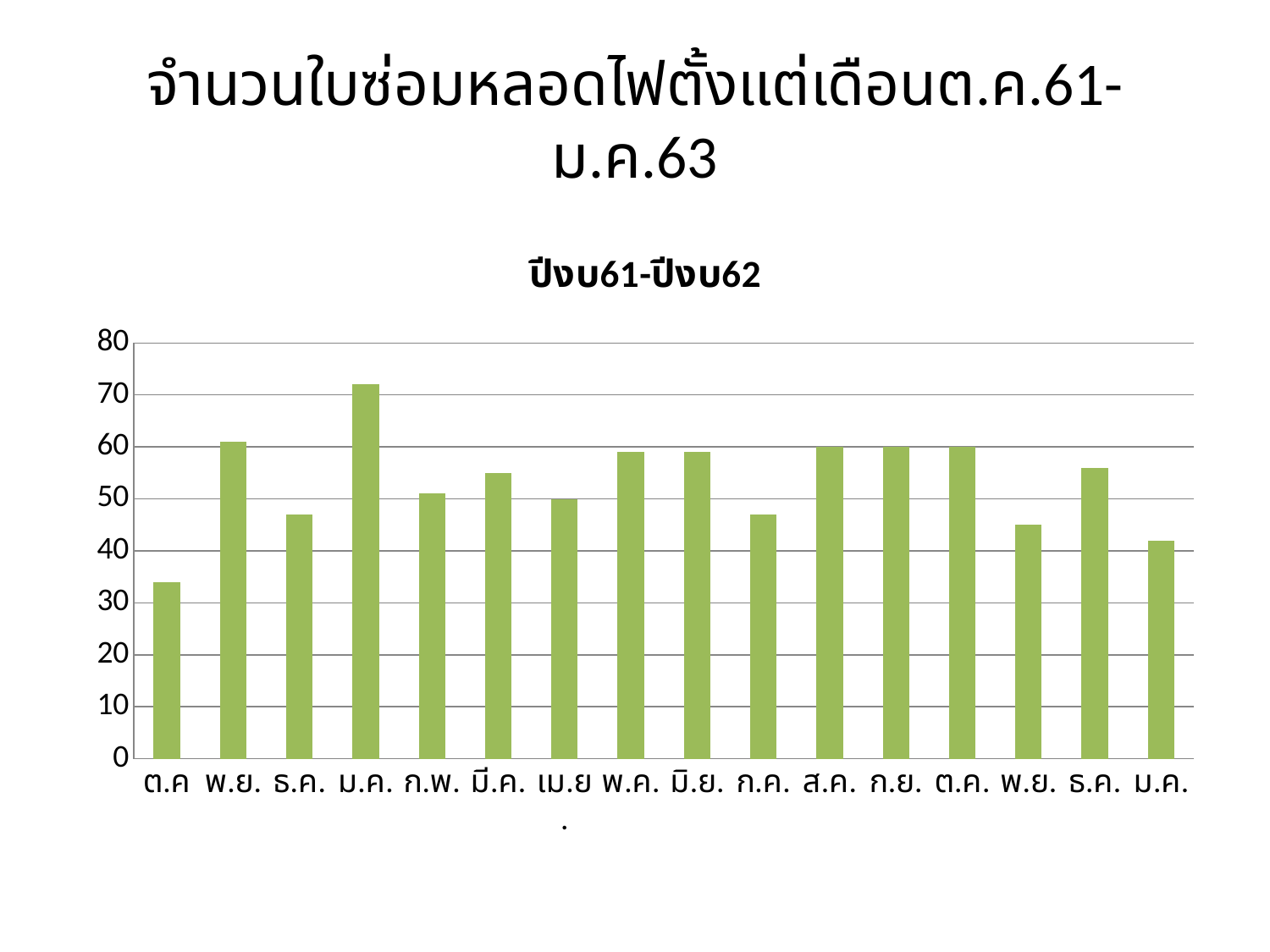
Which is larger, the value for the first bar (ต.ค) or the value for the last bar (ม.ค.)? ม.ค. (the last bar) Is the value for the first bar (ต.ค) greater or less than 40? less Which month has the lowest bar in the chart? ต.ค (the first bar) Which month has the highest bar in the chart? ม.ค. (the fourth bar) What kind of chart is shown on the slide? bar chart Is the value for มี.ค. greater or less than 50? greater Is the value for the last bar (ม.ค., rightmost) greater or less than 50? less How many bars (months) are plotted in the chart? 16 What is the title printed directly above the chart's plot area? ปีงบ61-ปีงบ62